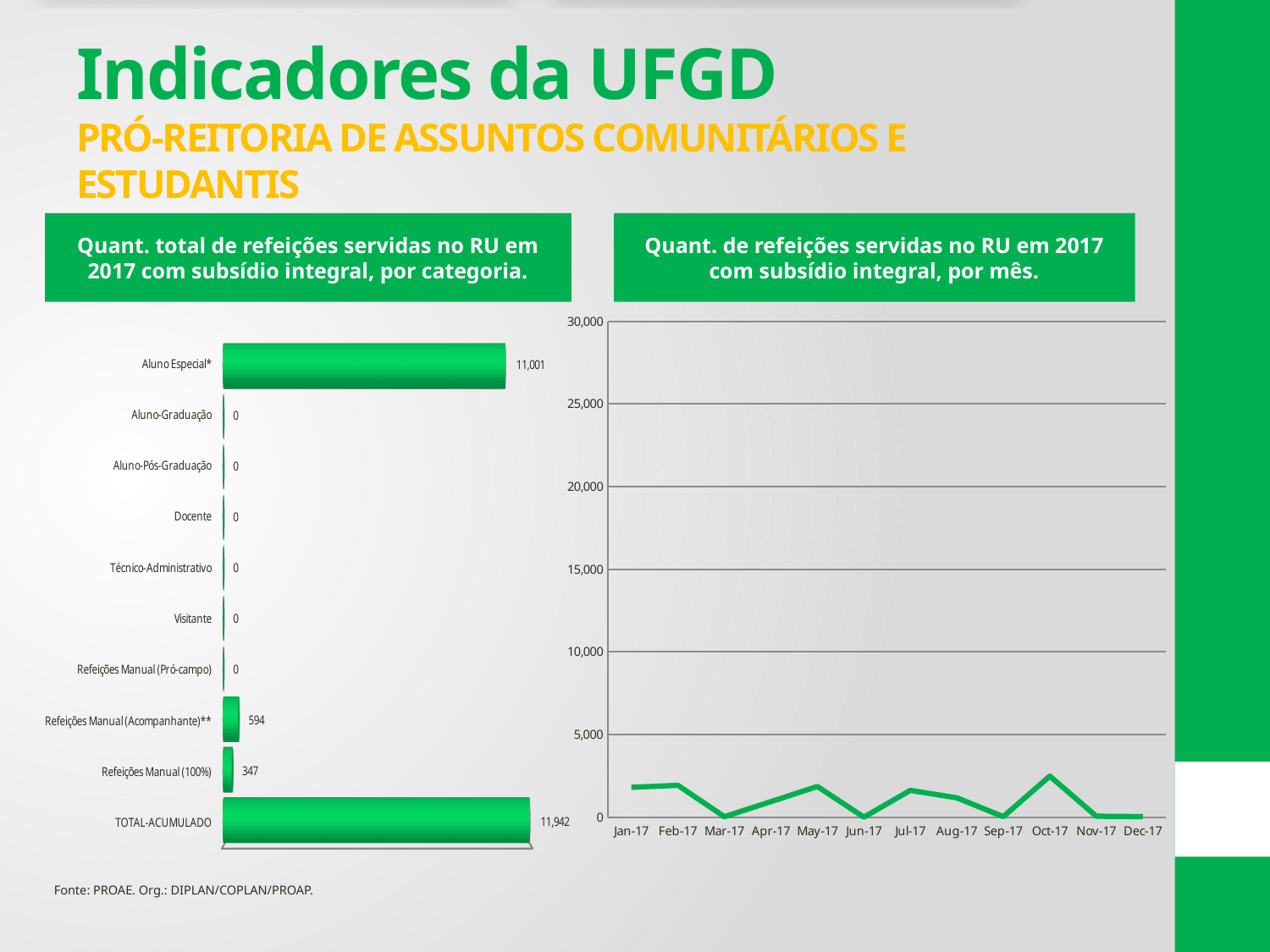
What kind of chart is 'Quant. total de refeições servidas no RU em 2017 com subsídio integral, por categoria'? Bar chart In the chart 'Quant. total de refeições servidas no RU em 2017 com subsídio integral, por categoria', what is the value for TOTAL-ACUMULADO? 11,942 In the chart 'Quant. total de refeições servidas no RU em 2017 com subsídio integral, por categoria', what is the value for Refeições Manual (Acompanhante)**? 594 In the chart 'Quant. total de refeições servidas no RU em 2017 com subsídio integral, por categoria', which category other than TOTAL-ACUMULADO has the highest value? Aluno Especial* In the chart 'Quant. total de refeições servidas no RU em 2017 com subsídio integral, por categoria', what is the difference between Refeições Manual (Acompanhante)** and Refeições Manual (100%)? 247 In the chart 'Quant. total de refeições servidas no RU em 2017 com subsídio integral, por categoria', what is the value for Aluno Especial*? 11,001 In the chart 'Quant. total de refeições servidas no RU em 2017 com subsídio integral, por categoria', what is the value for Refeições Manual (100%)? 347 In the chart 'Quant. total de refeições servidas no RU em 2017 com subsídio integral, por categoria', how many categories have a value of 0? 6 In the chart 'Quant. de refeições servidas no RU em 2017 com subsídio integral, por mês', is the value for Oct-17 greater or less than 5,000? less In the chart 'Quant. total de refeições servidas no RU em 2017 com subsídio integral, por categoria', which is larger, Refeições Manual (Acompanhante)** or Refeições Manual (100%)? Refeições Manual (Acompanhante)** What kind of chart is 'Quant. de refeições servidas no RU em 2017 com subsídio integral, por mês'? Line chart In the chart 'Quant. de refeições servidas no RU em 2017 com subsídio integral, por mês', how many months are plotted on the x axis? 12